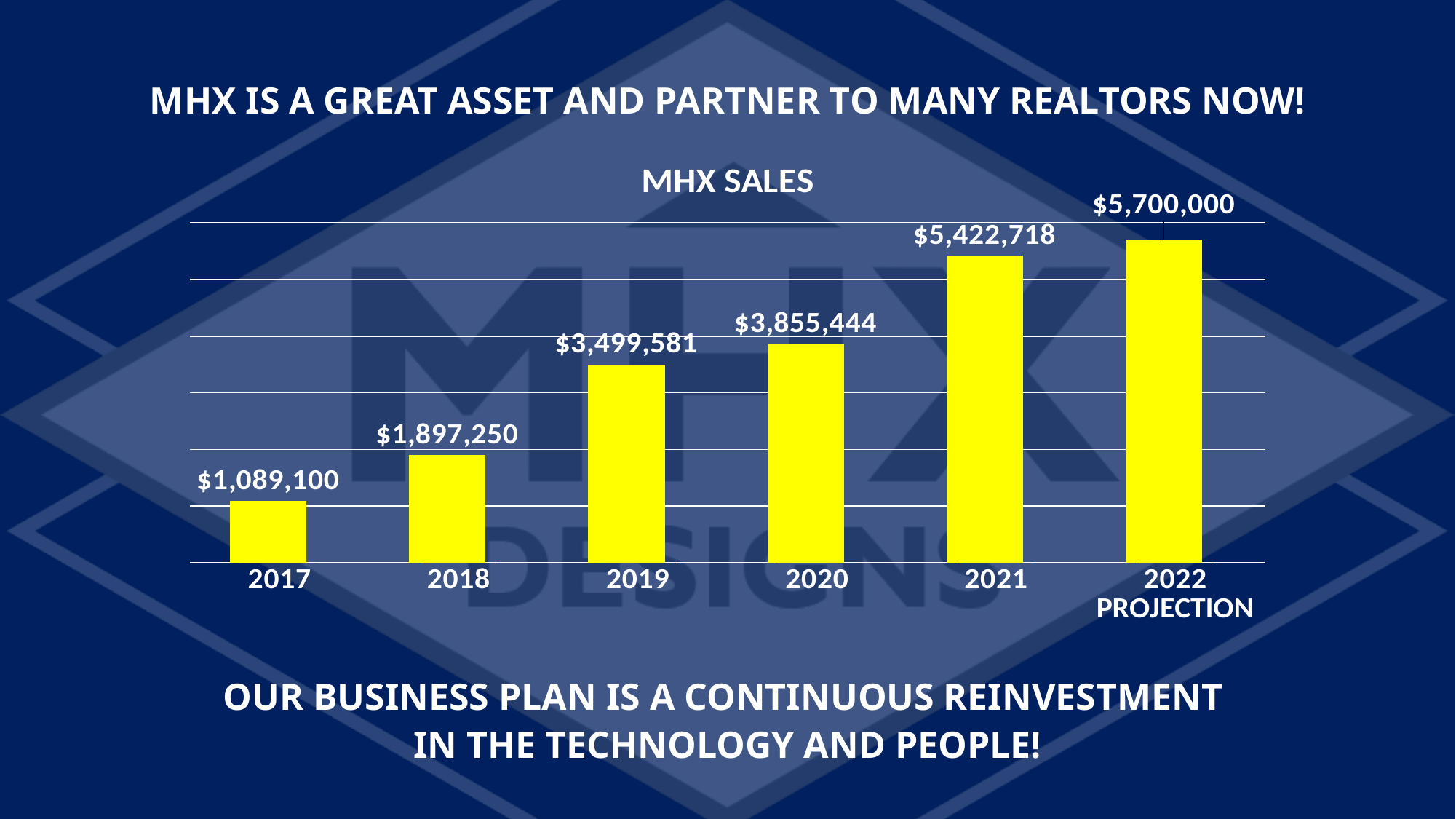
How many years (categories) are shown on the MHX SALES chart? 6 Do the MHX sales values rise or fall from 2017 to 2022? Rise Which year has the larger MHX sales value, 2019 or 2020? 2020 What is the MHX sales value for 2019? $3,499,581 What is the projected MHX sales value for 2022? $5,700,000 What kind of chart is the MHX SALES chart? Bar chart Which year has the lowest MHX sales value on the chart? 2017 What is the difference between the 2021 and 2020 MHX sales values? $1,567,274 What is the MHX sales value for 2017? $1,089,100 What is the difference between the 2022 projection and the 2021 MHX sales value? $277,282 What is the difference between the 2018 and 2017 MHX sales values? $808,150 Which year has the highest MHX sales value on the chart? 2022 PROJECTION